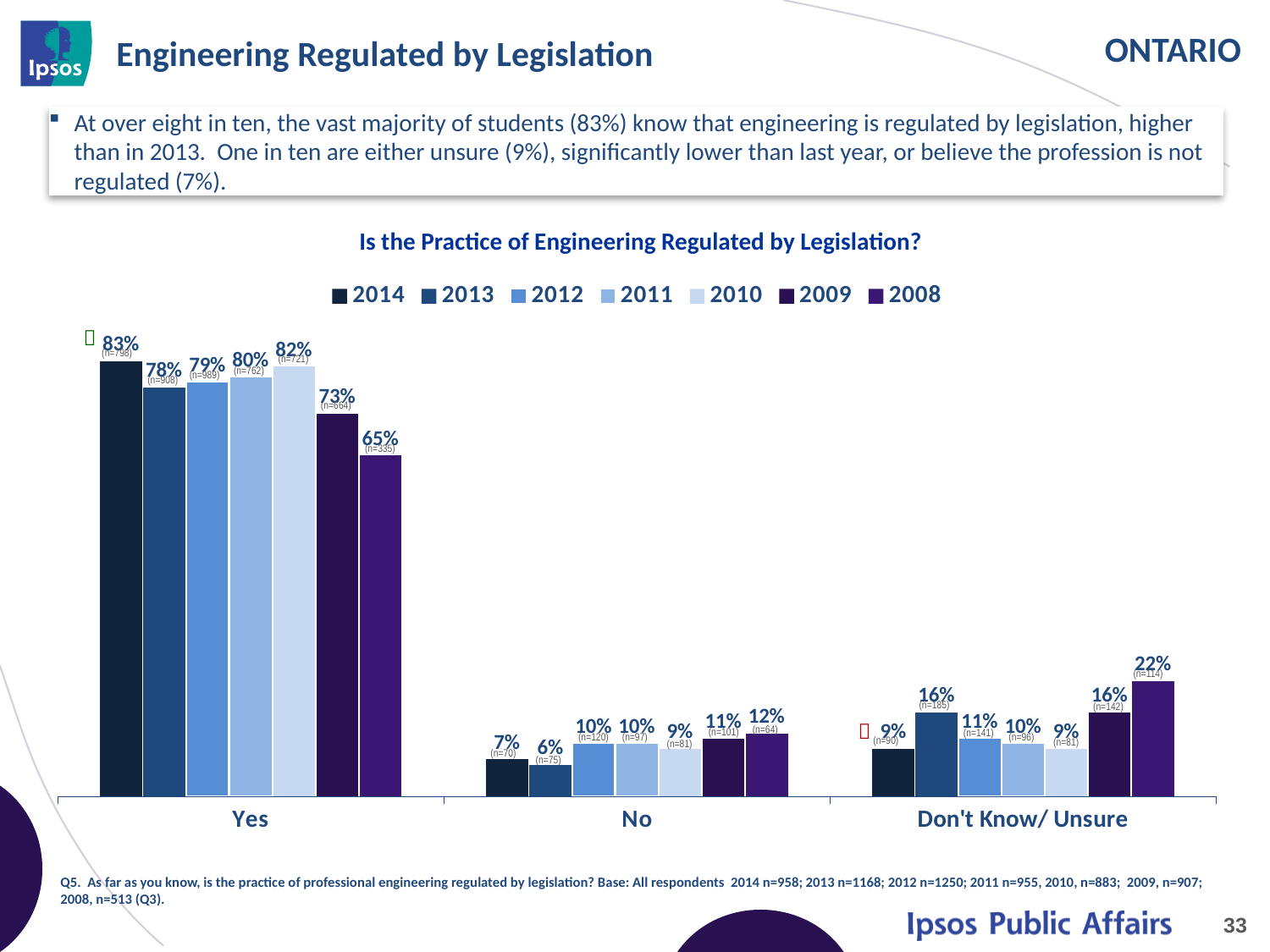
What kind of chart is shown on the slide? Bar chart What percentage answered "No" in 2013? 6% Which year has the highest value in the "Yes" category? 2014 What percentage of students answered "Yes" in 2014? 83% What is the value for 2008 in the "Don't Know/ Unsure" category? 22% What is the value for 2008 in the "Yes" category? 65% Which year has the lowest value in the "Yes" category? 2008 Which is larger: the 2013 value or the 2014 value for "Don't Know/ Unsure"? 2013 What is the difference between the 2014 and 2013 values in the "Yes" category? 5% How many response categories are shown on the x axis? 3 What is the title of the chart? Is the Practice of Engineering Regulated by Legislation? How many series does the legend list? 7